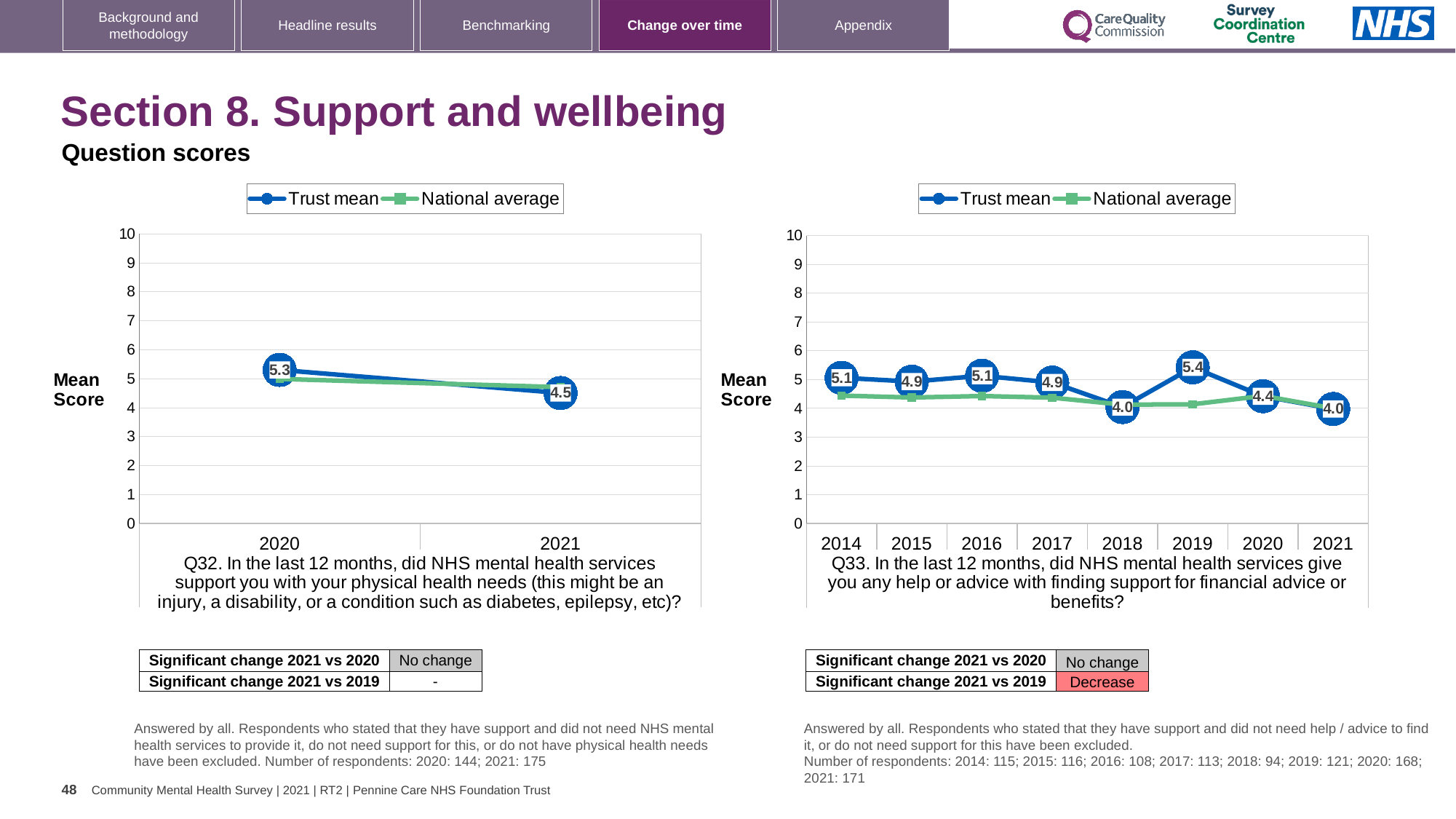
In the Q33 chart on the right, what is the difference between the Trust mean in 2019 and in 2020? 1.0 In the Q33 chart on the right, what is the Trust mean for 2021? 4.0 In the Q32 chart on the left, by how much did the Trust mean fall from 2020 to 2021? 0.8 What kind of chart is the Q33 chart on the right? Line chart How many series does the legend of the Q32 chart on the left list? 2 In the Q33 chart on the right, is the Trust mean higher in 2016 or in 2018? 2016 In the Q33 chart on the right, what is the Trust mean for 2019? 5.4 In the Q32 chart on the left, what is the Trust mean for 2021? 4.5 In the Q32 chart on the left, what is the Trust mean for 2020? 5.3 In the Q33 chart on the right, how many years are shown on the x axis? 8 In the Q33 chart on the right, which year has the highest Trust mean? 2019 In the Q33 chart on the right, is the National average for 2018 greater or less than 5? less